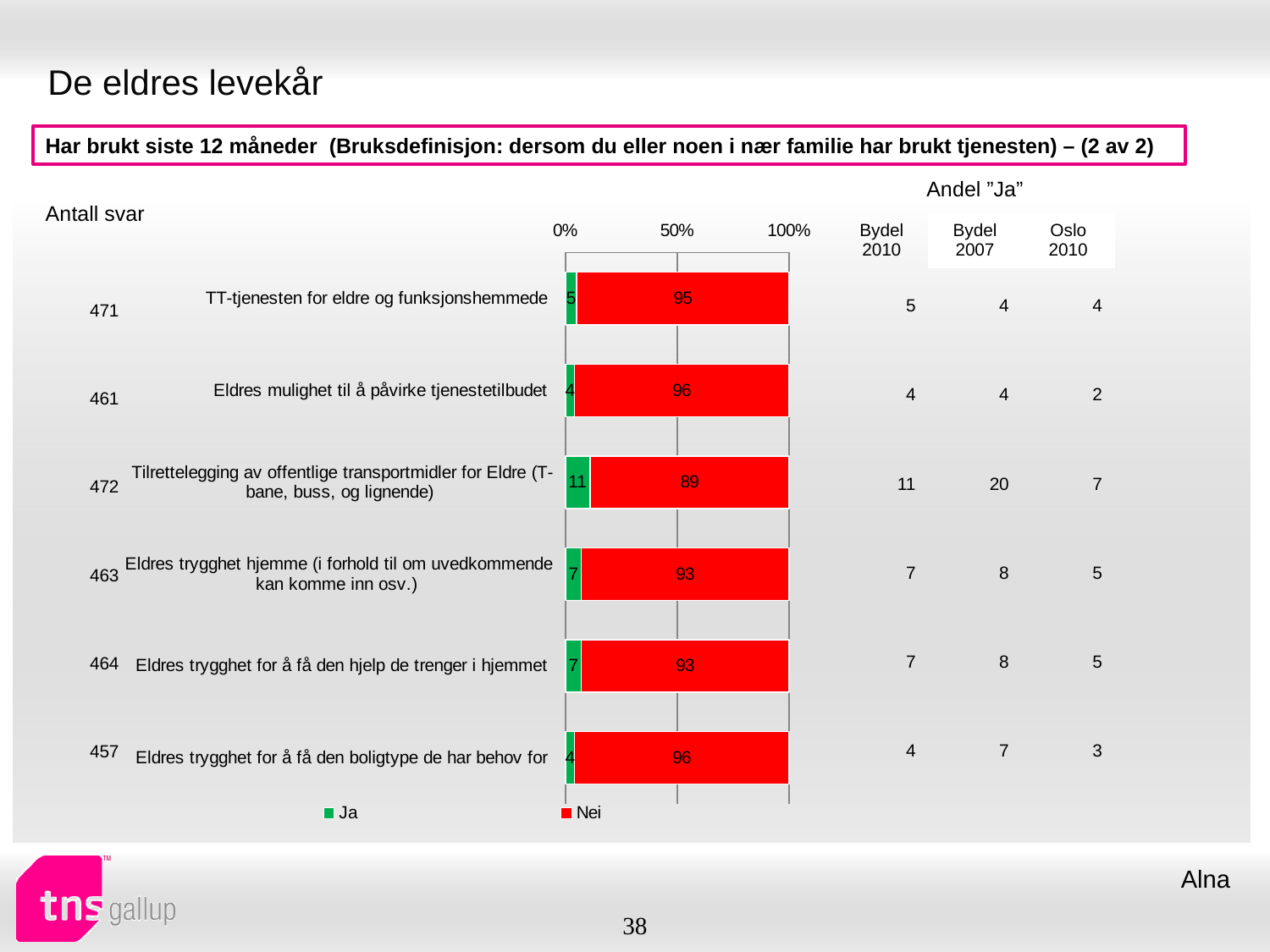
What is the "Ja" value for "Tilrettelegging av offentlige transportmidler for Eldre (T-bane, buss, og lignende)"? 11 What kind of chart is shown on the slide? bar chart Which colour represents the "Nei" series in the chart? red What is the total of the stacked bar for "Eldres trygghet for å få den hjelp de trenger i hjemmet"? 100 Which is larger: the "Ja" value for "Eldres trygghet hjemme (i forhold til om uvedkommende kan komme inn osv.)" or the "Ja" value for "TT-tjenesten for eldre og funksjonshemmede"? Eldres trygghet hjemme (i forhold til om uvedkommende kan komme inn osv.) How many series does the chart legend list? 2 How many categories (service items) are plotted in the chart? 6 Which category has the highest "Ja" value? Tilrettelegging av offentlige transportmidler for Eldre (T-bane, buss, og lignende) What is the "Nei" value for "Eldres trygghet for å få den boligtype de har behov for"? 96 What is the "Nei" value for "TT-tjenesten for eldre og funksjonshemmede"? 95 What is the difference between the "Nei" values for "Eldres mulighet til å påvirke tjenestetilbudet" and "Tilrettelegging av offentlige transportmidler for Eldre (T-bane, buss, og lignende)"? 7 Which category has the lowest "Nei" value? Tilrettelegging av offentlige transportmidler for Eldre (T-bane, buss, og lignende)